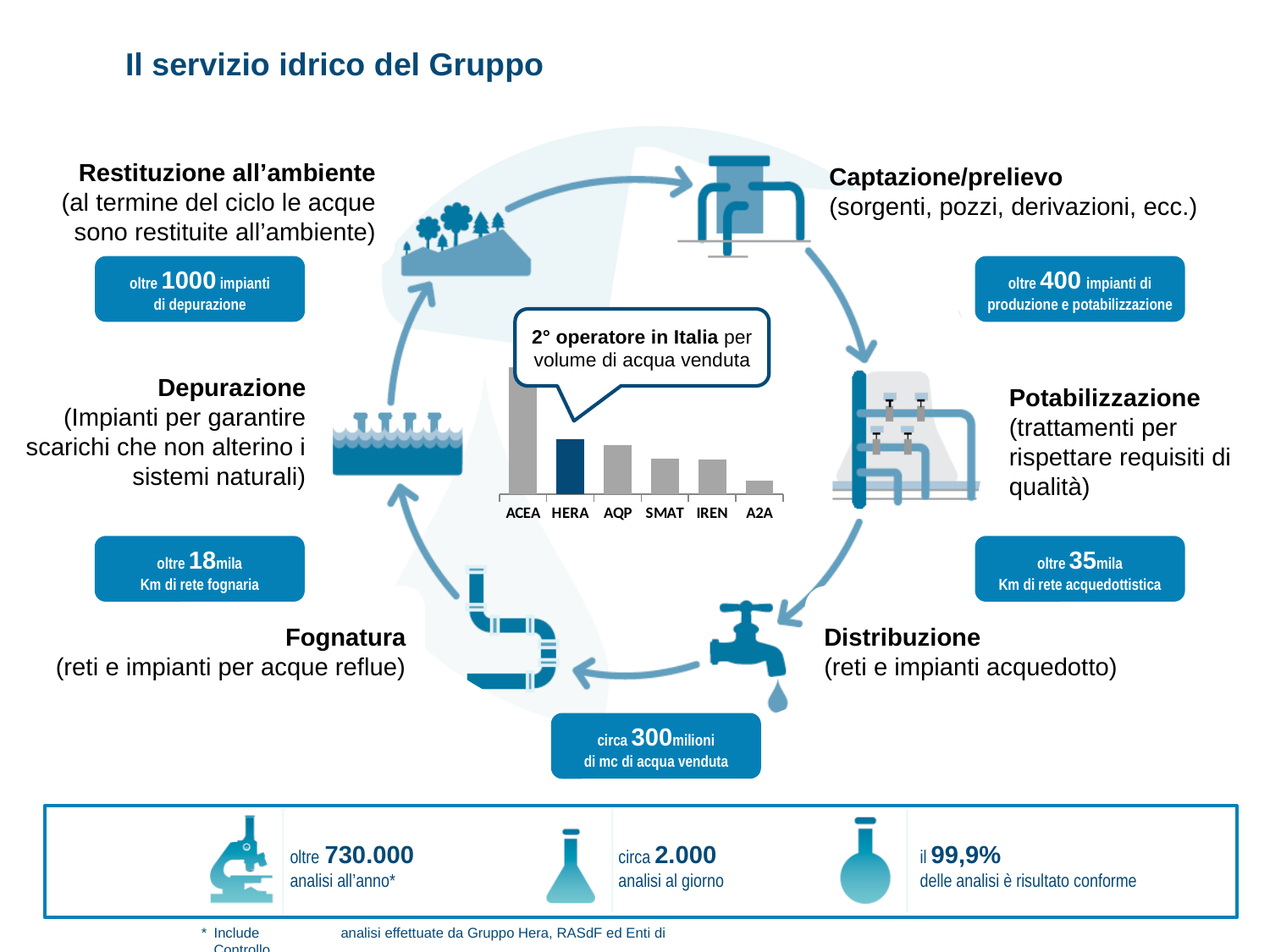
In the centre chart, which bar is taller, AQP or A2A? AQP In the centre chart, which bar is taller, ACEA or HERA? ACEA In the centre chart, which bar is taller, HERA or AQP? HERA How many operators are shown as bars in the centre chart? 6 Which operator has the tallest bar in the centre chart? ACEA Which operator has the shortest bar in the centre chart? A2A What kind of chart is shown in the centre of the slide? bar chart What does the callout above the centre chart say about HERA's position in Italy? 2° operatore in Italia per volume di acqua venduta Do the bar heights in the centre chart rise or fall from left to right? fall What is the label of the first bar on the left of the centre chart? ACEA Which operator's bar is highlighted in dark blue in the centre chart? HERA